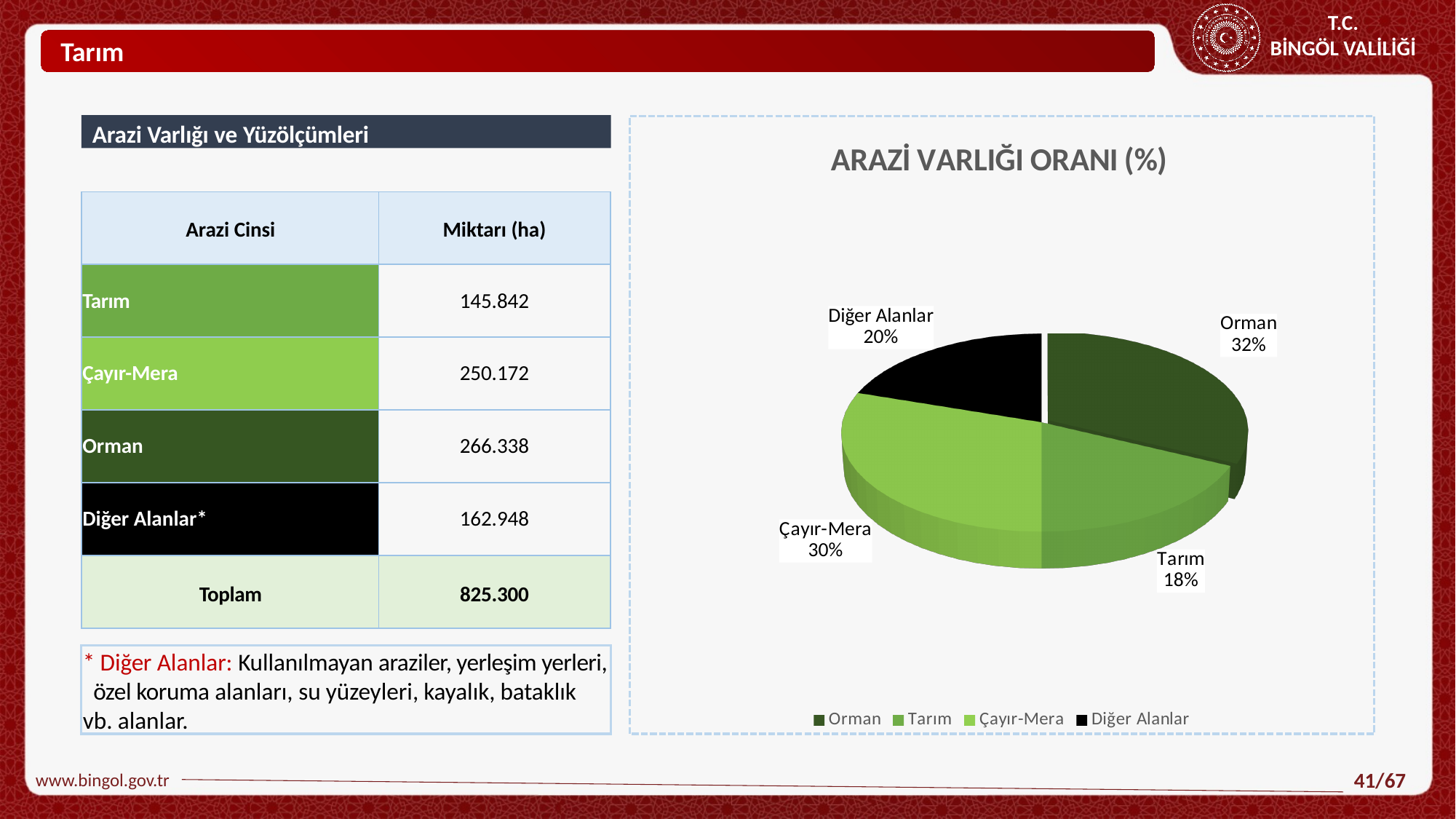
How many slices does the pie chart have? 4 What is the difference in percentage points between the Orman and Tarım slices? 14 Which slice of the pie chart is the largest? Orman How many entries does the legend of the pie chart list? 4 What share of the pie does Tarım have? 18% Which slice of the pie chart is the smallest? Tarım What share of the pie does Diğer Alanlar have? 20% What share of the pie does Orman have? 32% What is the title of the pie chart? ARAZİ VARLIĞI ORANI (%) What kind of chart is shown on the slide? pie chart Which slice is larger, Çayır-Mera or Diğer Alanlar? Çayır-Mera